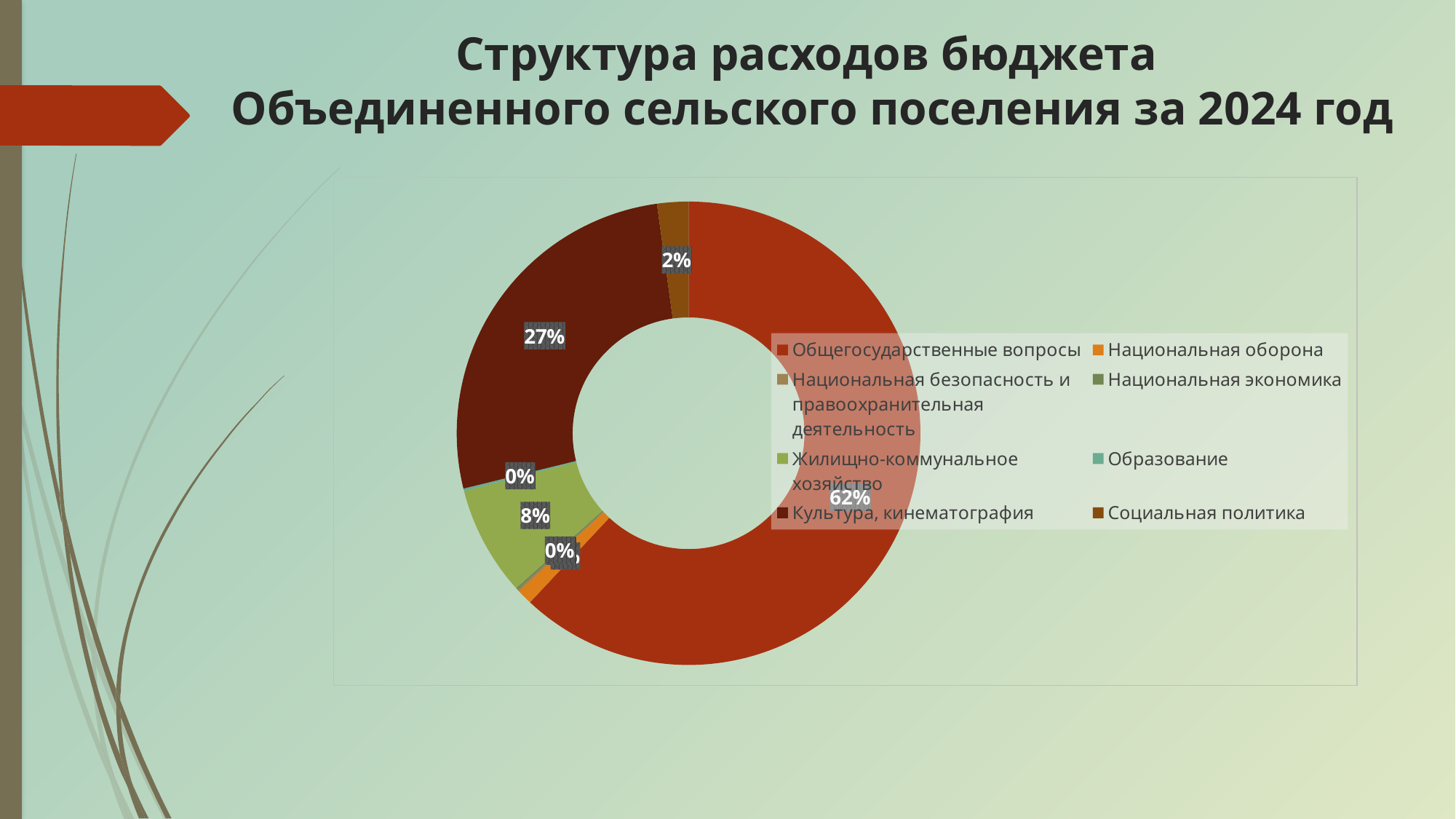
What kind of chart is shown on the slide? doughnut (pie) chart What share is labelled for Жилищно-коммунальное хозяйство? 8% What share of budget expenditure is labelled for Общегосударственные вопросы? 62% What is the title of the slide containing the chart? Структура расходов бюджета Объединенного сельского поселения за 2024 год What share is labelled for Культура, кинематография? 27% By how many percentage points does Культура, кинематография exceed Жилищно-коммунальное хозяйство? 19 percentage points How many categories does the legend list? 8 Which legend entry is shown in light green? Жилищно-коммунальное хозяйство Which category has the largest share of the chart? Общегосударственные вопросы By how many percentage points does Общегосударственные вопросы exceed Культура, кинематография? 35 percentage points Which is larger: the share for Культура, кинематография or for Жилищно-коммунальное хозяйство? Культура, кинематография